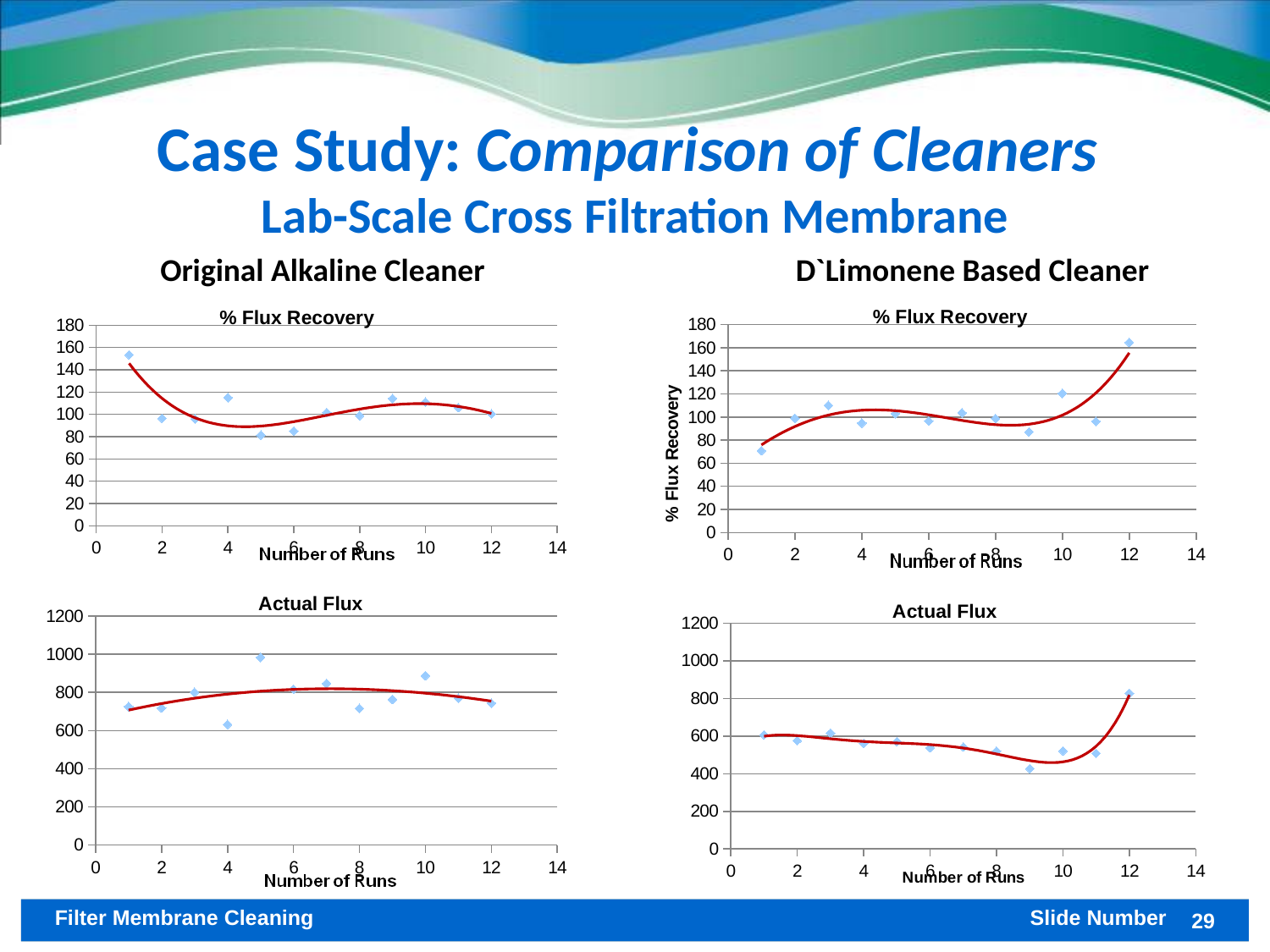
On the Original Alkaline Cleaner '% Flux Recovery' chart, is the value at run 5 greater or less than 100? less On the D`Limonene Based Cleaner 'Actual Flux' chart, is the value at run 9 greater or less than 600? less On the D`Limonene Based Cleaner '% Flux Recovery' chart, is the value at run 12 greater or less than 140? greater On the D`Limonene Based Cleaner 'Actual Flux' chart, at which run number is the lowest value plotted? 9 On the Original Alkaline Cleaner '% Flux Recovery' chart, at which run number is the highest value plotted? 1 On the D`Limonene Based Cleaner '% Flux Recovery' chart, at which run number is the highest value plotted? 12 What kind of chart is the Original Alkaline Cleaner 'Actual Flux' chart? scatter chart On the Original Alkaline Cleaner 'Actual Flux' chart, which run has the larger value, run 5 or run 4? run 5 How many data points are plotted on the D`Limonene Based Cleaner 'Actual Flux' chart? 12